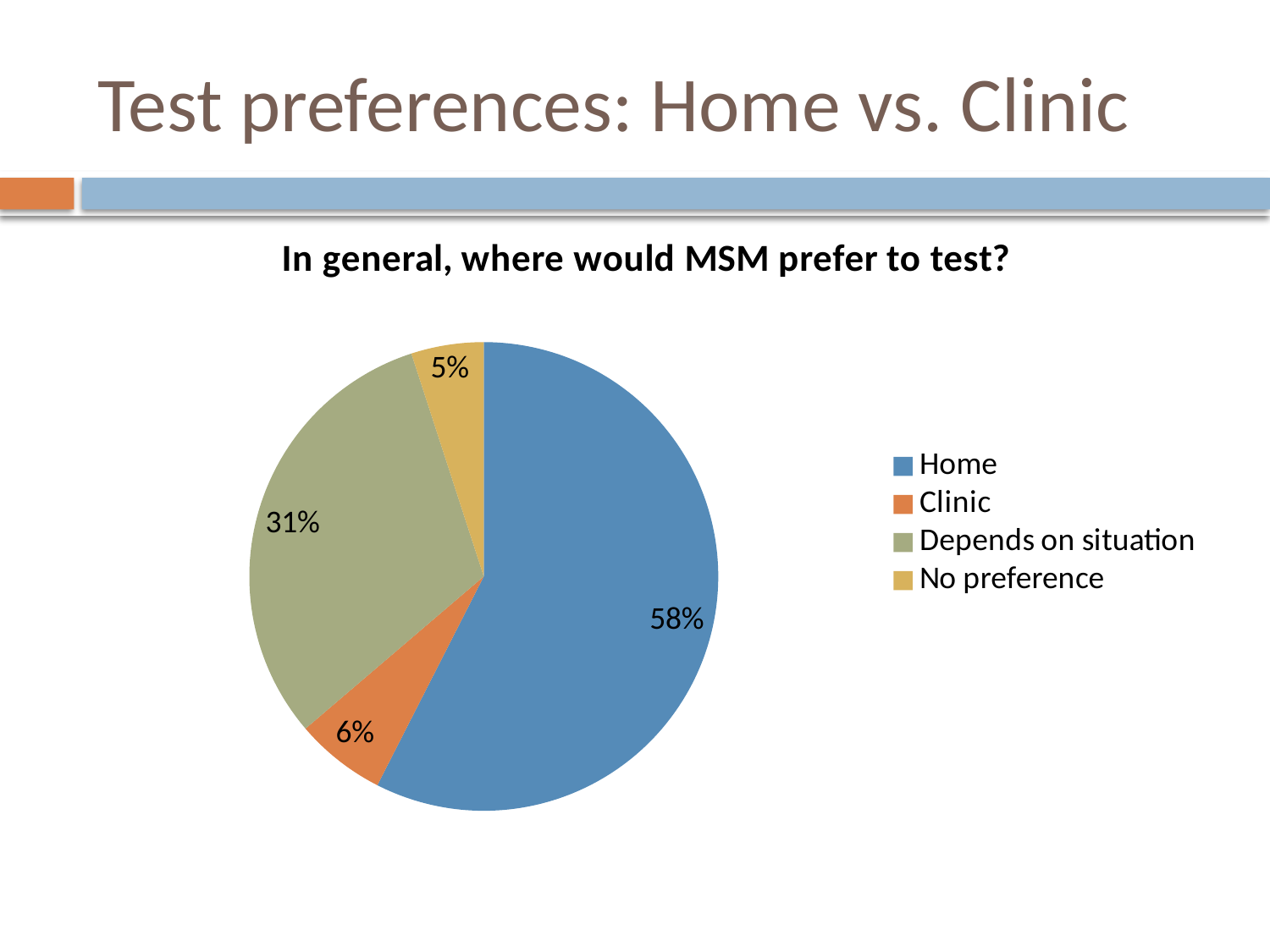
What percentage of respondents had no preference? 5% What is the difference in percentage points between Home and Depends on situation? 27 How many categories does the legend list? 4 What percentage of MSM prefer to test at home? 58% What share of the pie is labelled 'Depends on situation'? 31% Which category has the smallest slice of the pie? No preference What colour is the Home slice in the pie chart? blue What percentage of MSM prefer to test at a clinic? 6% What type of chart is shown on the slide? pie chart What is the title of the chart? In general, where would MSM prefer to test? Which is larger, the share for Clinic or the share for Depends on situation? Depends on situation Which category has the largest slice of the pie? Home